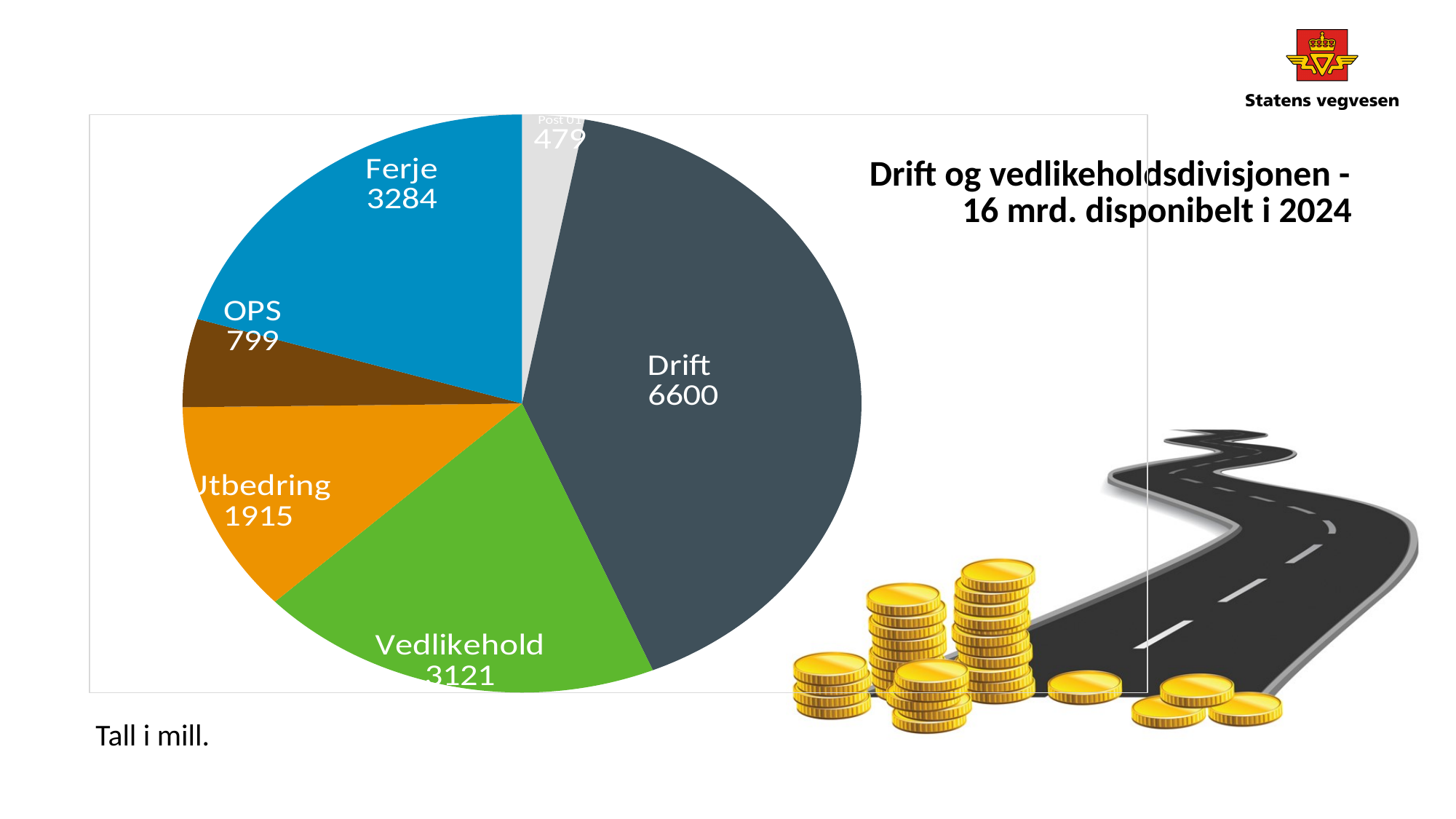
What is the value of the Vedlikehold slice in the pie chart? 3121 Which is larger in the pie chart, Utbedring or OPS? Utbedring What is the difference between the Drift and Vedlikehold values in the pie chart? 3479 What is the value of the Drift slice in the pie chart? 6600 Which slice of the pie chart has the largest value? Drift What is the value of the Ferje slice in the pie chart? 3284 What is the value of the Utbedring slice in the pie chart? 1915 What is the value of the OPS slice in the pie chart? 799 How many slices does the pie chart have? 6 What is the difference between the Ferje and Vedlikehold values in the pie chart? 163 Which slice of the pie chart has the smallest value? Post 01 What kind of chart is shown on the slide? Pie chart